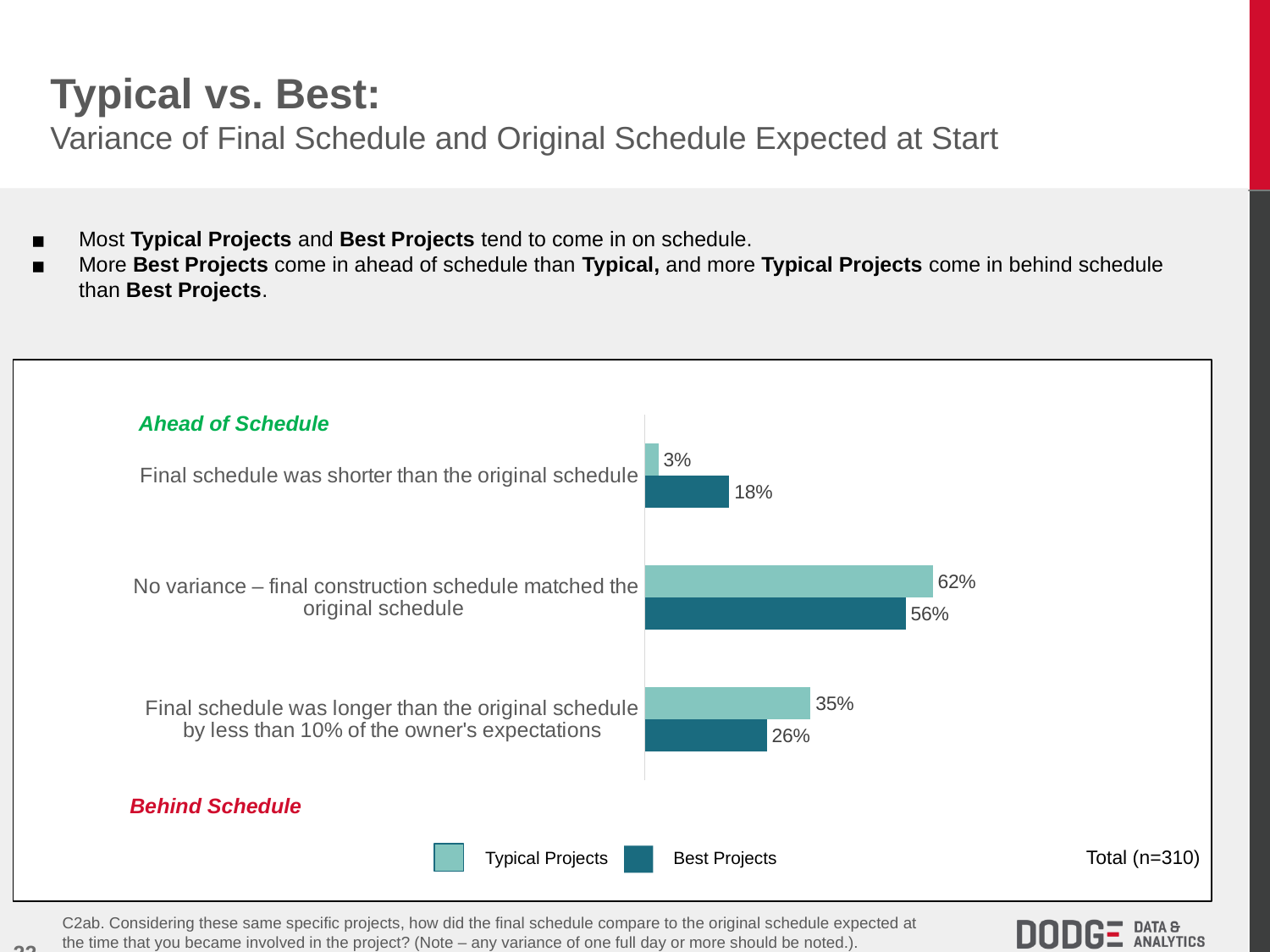
What percentage of Typical Projects had a final schedule shorter than the original schedule? 3% Which category has the highest value for Best Projects? No variance – final construction schedule matched the original schedule For the 'Final schedule was longer than the original schedule by less than 10%' category, which series has the larger value, Typical Projects or Best Projects? Typical Projects What percentage of Best Projects had a final schedule longer than the original schedule by less than 10% of the owner's expectations? 26% What is the difference between Typical Projects and Best Projects for the 'No variance' category? 6% What percentage of Best Projects had a final schedule shorter than the original schedule? 18% What kind of chart is shown on the slide? Bar chart How many categories are shown on the chart? 3 What is the difference between Typical Projects and Best Projects for the 'Final schedule was shorter than the original schedule' category? 15% What percentage of Typical Projects had no variance between the final and original schedule? 62% How many series does the legend list? 2 Which category has the lowest value for Typical Projects? Final schedule was shorter than the original schedule